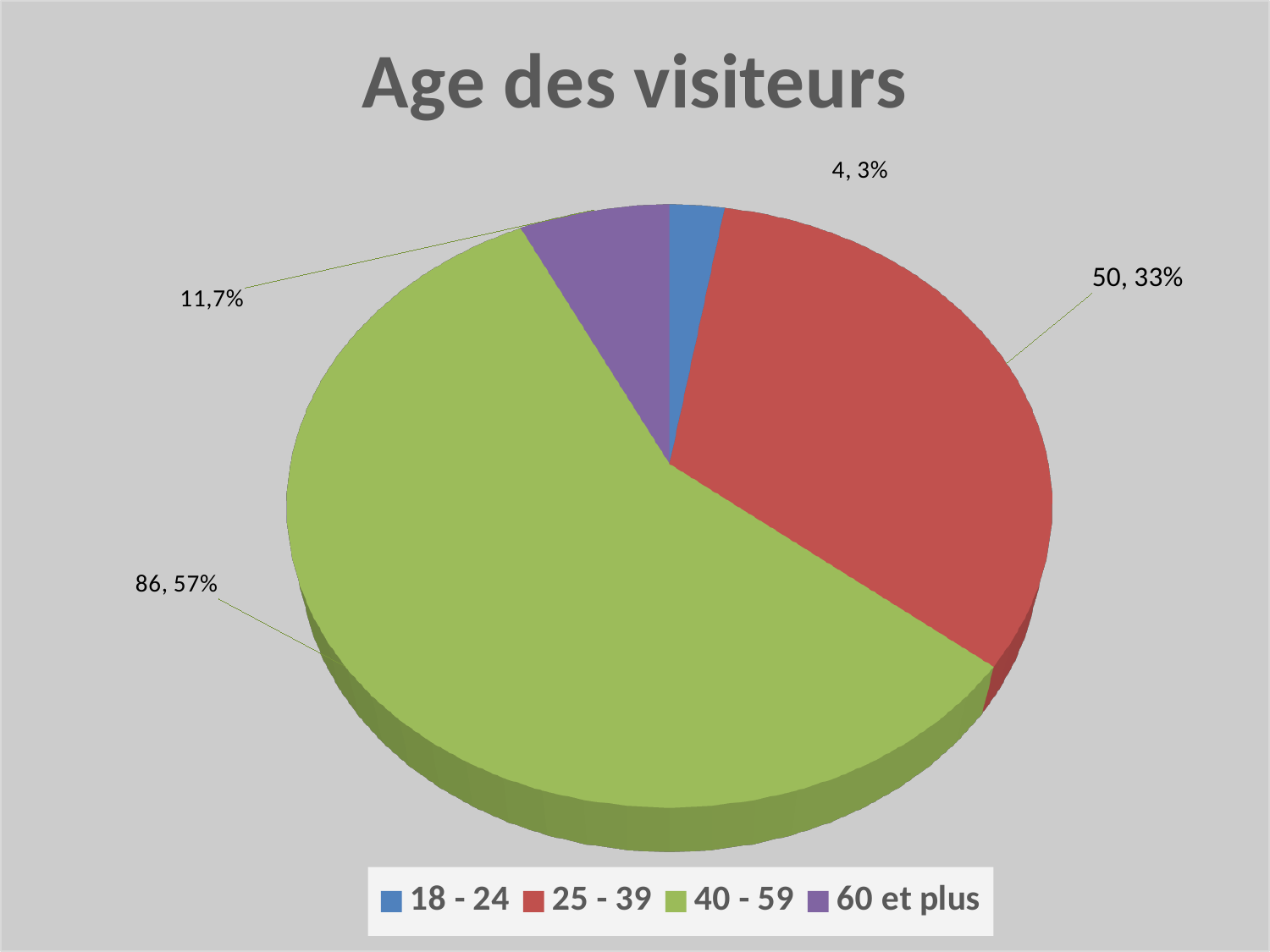
How many entries does the legend list? 4 Which age group has the largest slice? 40 - 59 What percentage share does the 25 - 39 age group have? 33% How many slices does the pie chart have? 4 What is the title of the chart? Age des visiteurs Which age group has the smallest slice? 18 - 24 Which is larger, the value for 60 et plus or the value for 18 - 24? 60 et plus What is the value for the 40 - 59 age group? 86 What is the value for the 18 - 24 age group? 4 What kind of chart is shown on the slide? pie chart What is the difference between the values for 40 - 59 and 25 - 39? 36 What percentage share does the 60 et plus age group have? 7%